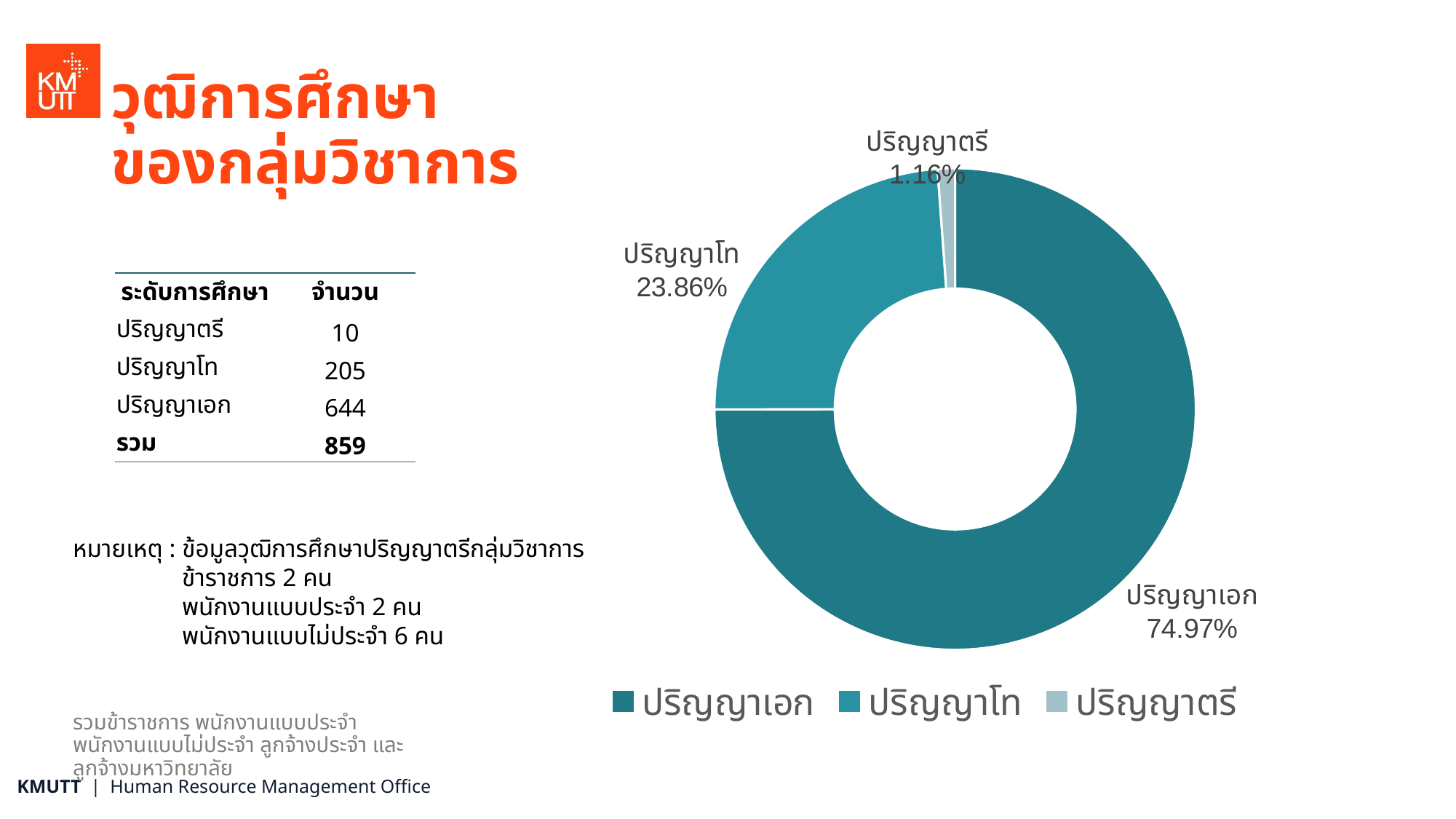
Which slice is larger in the donut chart, ปริญญาโท or ปริญญาตรี? ปริญญาโท What percentage share does the ปริญญาเอก slice have in the donut chart? 74.97% Which category has the smallest slice in the donut chart? ปริญญาตรี Which category has the largest slice in the donut chart? ปริญญาเอก What percentage share does the ปริญญาตรี slice have in the donut chart? 1.16% Which legend entry is shown with the lightest colour in the donut chart? ปริญญาตรี What is the difference in percentage points between the ปริญญาเอก slice and the ปริญญาโท slice? 51.11% What kind of chart is shown on the slide? Donut (pie) chart What percentage share does the ปริญญาโท slice have in the donut chart? 23.86% How many entries does the legend of the donut chart list? 3 How many slices does the donut chart have? 3 What is the difference in percentage points between the ปริญญาโท slice and the ปริญญาตรี slice? 22.70%